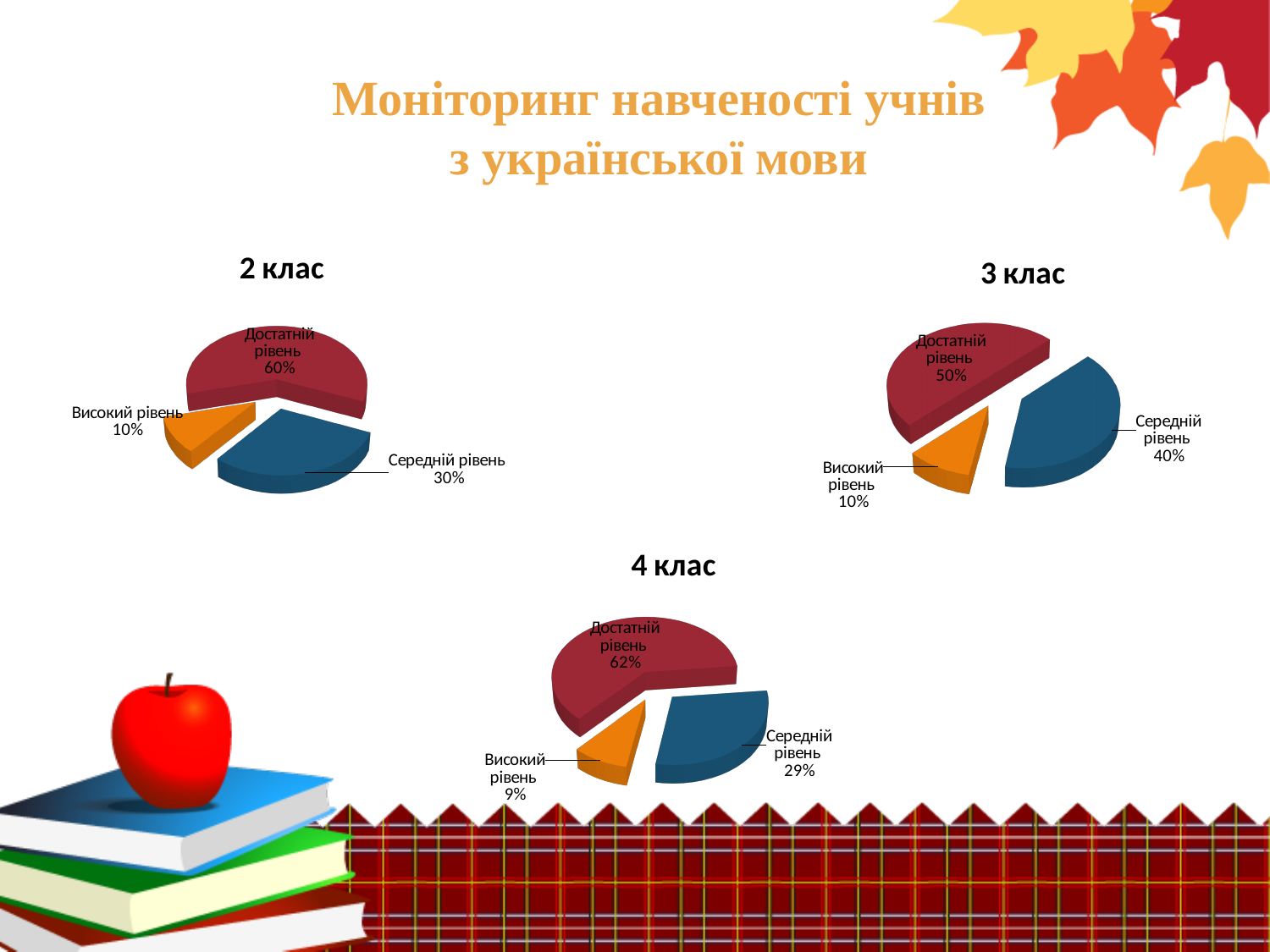
In the "4 клас" chart, what is the difference in percentage points between "Середній рівень" and "Високий рівень"? 20 How many slices does the "2 клас" chart have? 3 In the "3 клас" chart, which is larger: "Достатній рівень" or "Середній рівень"? Достатній рівень What is the title of the chart positioned at the bottom centre of the slide? 4 клас In the "4 клас" chart, what share is labelled for "Високий рівень"? 9% How many charts are shown on the slide? 3 In the "3 клас" chart, what share is labelled for "Середній рівень"? 40% In the "2 клас" chart, what is the difference in percentage points between "Достатній рівень" and "Середній рівень"? 30 What type of chart is used for "4 клас"? Pie chart In the "2 клас" chart, what share is labelled for "Достатній рівень"? 60% In the "3 клас" chart, which category has the smallest slice? Високий рівень In the "4 клас" chart, which category has the largest slice? Достатній рівень